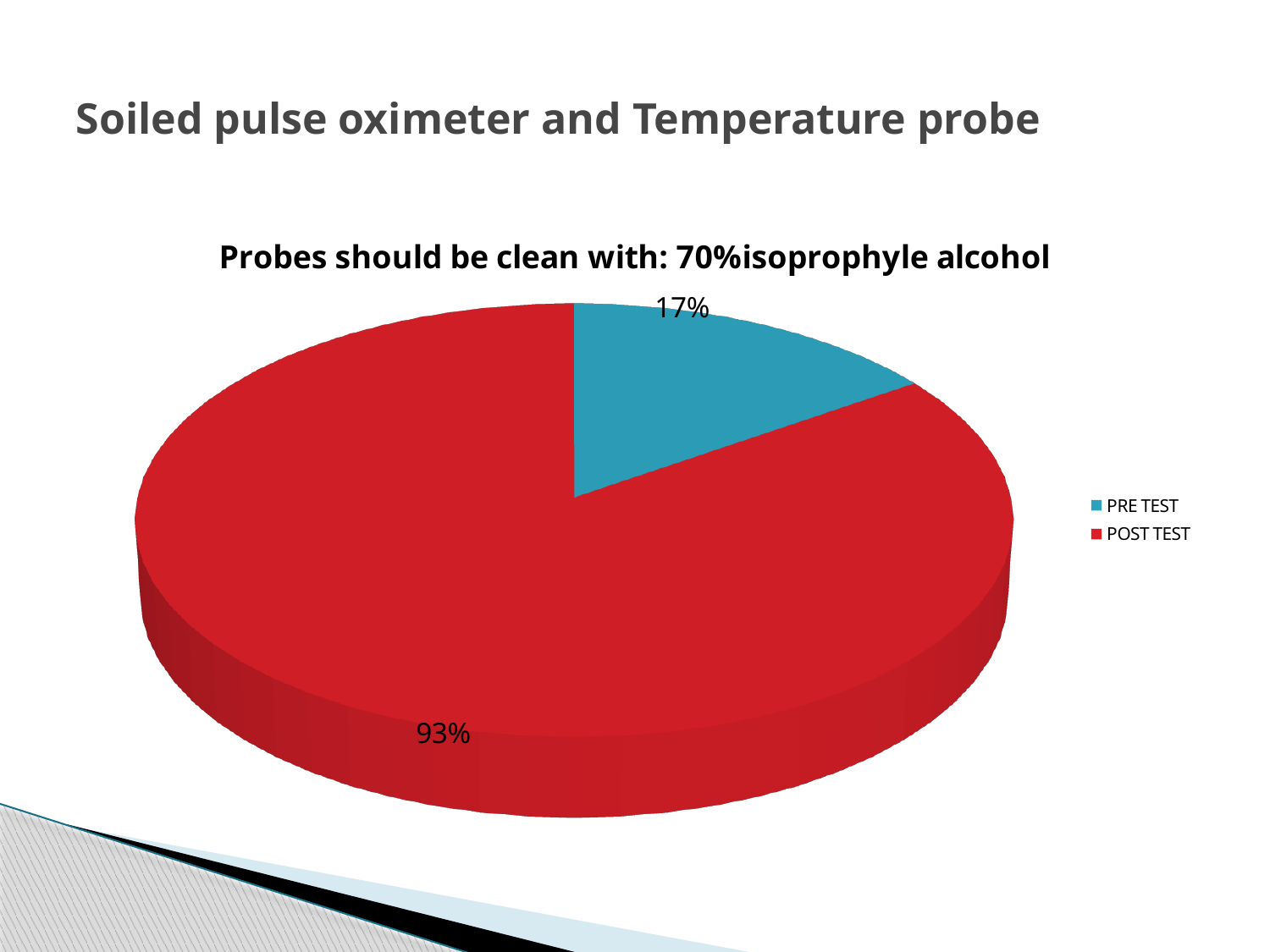
How many entries does the legend list? 2 How many slices does the pie chart have? 2 What value is shown for PRE TEST? 17% What is the difference between the POST TEST value and the PRE TEST value? 76 percentage points What colour is the POST TEST slice? Red What kind of chart is shown on the slide? Pie chart What is the chart's title? Probes should be clean with: 70%isoprophyle alcohol Which category has the smallest slice of the pie? PRE TEST Which is larger, the value for PRE TEST or the value for POST TEST? POST TEST Which category has the largest slice of the pie? POST TEST What value is shown for POST TEST? 93%